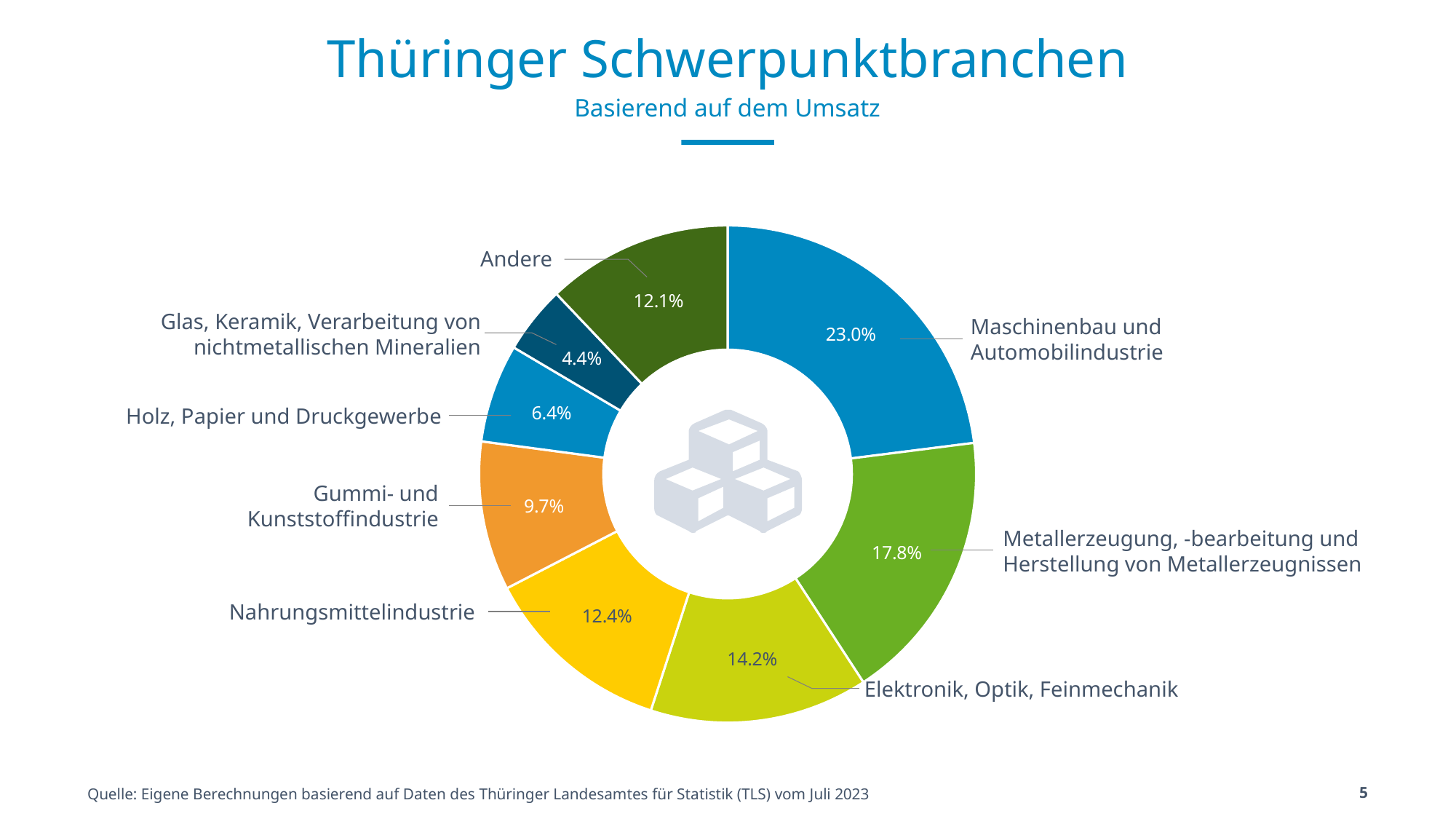
Which is larger: Gummi- und Kunststoffindustrie or Holz, Papier und Druckgewerbe? Gummi- und Kunststoffindustrie What share of the chart does Maschinenbau und Automobilindustrie hold? 23.0% Which is larger: Elektronik, Optik, Feinmechanik or Nahrungsmittelindustrie? Elektronik, Optik, Feinmechanik How many categories are shown in the chart? 8 What is the difference in percentage points between Maschinenbau und Automobilindustrie and Metallerzeugung, -bearbeitung und Herstellung von Metallerzeugnissen? 5.2 What is the title of the chart? Thüringer Schwerpunktbranchen What is the value shown for the Andere slice? 12.1% What is the value shown for Nahrungsmittelindustrie? 12.4% Which category has the largest share of the chart? Maschinenbau und Automobilindustrie What percentage is shown for Holz, Papier und Druckgewerbe? 6.4% Which category has the smallest share of the chart? Glas, Keramik, Verarbeitung von nichtmetallischen Mineralien What kind of chart is shown on the slide? Pie chart (donut)